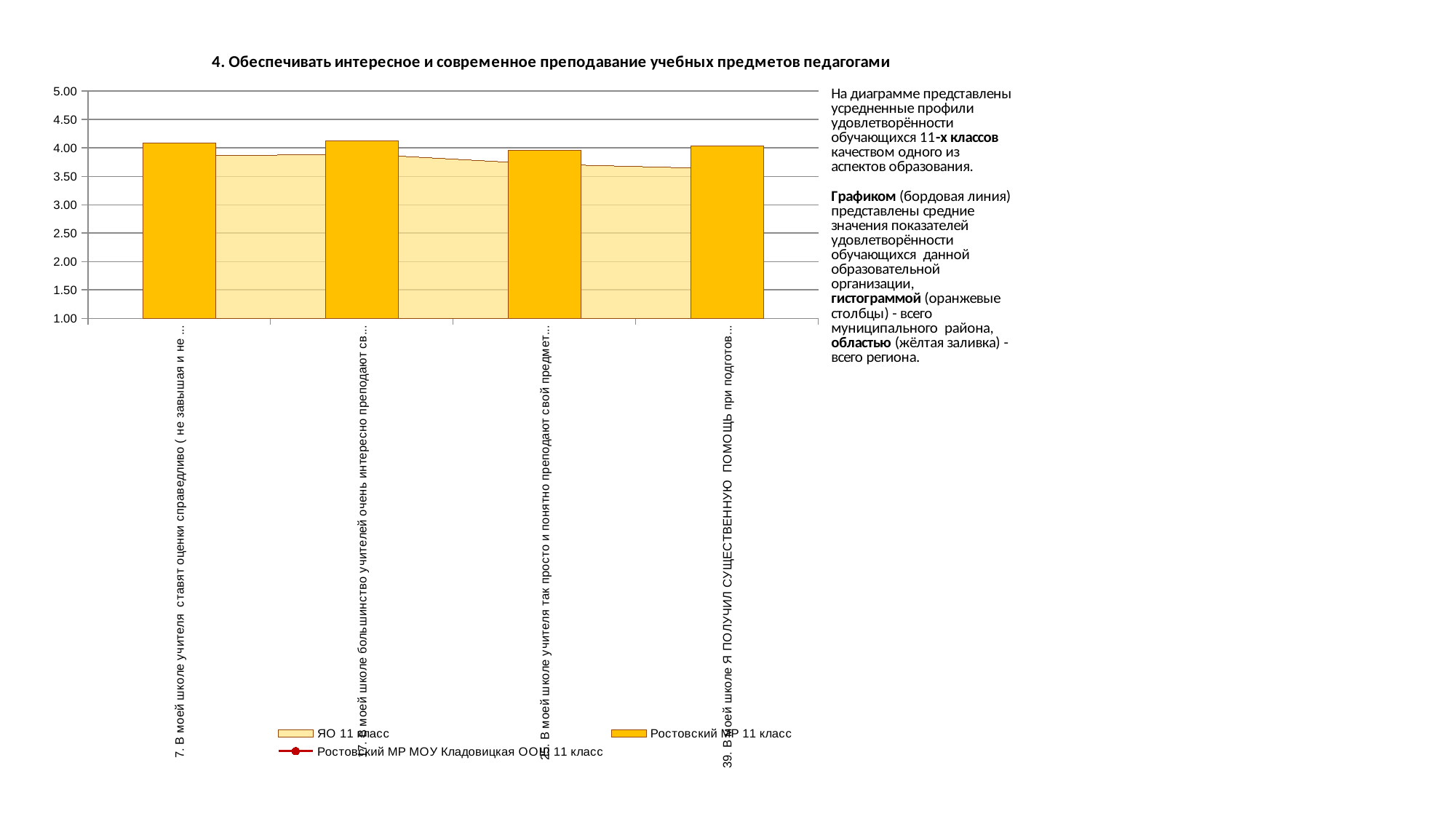
What kind of chart is used for the series 'Ростовский МР 11 класс'? bar chart What is the title of the chart? 4. Обеспечивать интересное и современное преподавание учебных предметов педагогами Which series is shown with orange bars? Ростовский МР 11 класс Which category has the lowest bar for 'Ростовский МР 11 класс'? 25. В моей школе учителя так просто и понятно преподают свой предмет... Do the 'ЯО 11 класс' values rise or fall from left to right along the x axis? fall Is the 'Ростовский МР 11 класс' bar for category 7 greater or less than 4.00? greater How many categories are shown on the x axis? 4 Is the 'ЯО 11 класс' value for category 39 greater or less than 4.00? less How many series does the legend list? 3